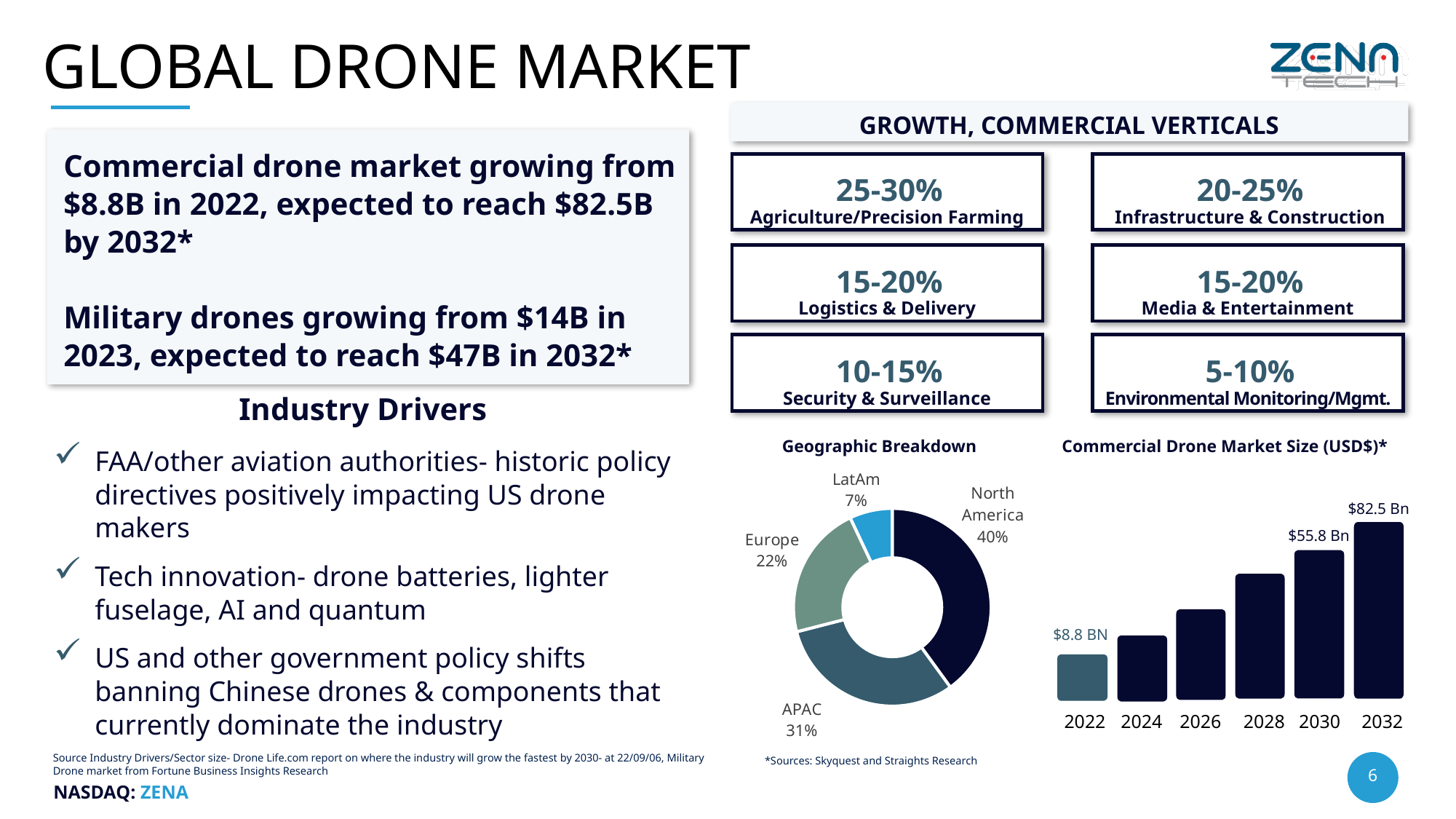
In the Commercial Drone Market Size (USD$) chart, do the values rise or fall from 2022 to 2032? Rise In the Commercial Drone Market Size (USD$) chart, what is the value for 2030? $55.8 Bn In the Geographic Breakdown chart, which region has the largest share? North America What kind of chart is the Geographic Breakdown chart? Donut (pie) chart In the Commercial Drone Market Size (USD$) chart, which year has the highest value? 2032 In the Geographic Breakdown chart, how many percentage points larger is Europe's share than LatAm's? 15 In the Geographic Breakdown chart, how many regions are shown? 4 In the Geographic Breakdown chart, which region has the smallest share? LatAm In the Commercial Drone Market Size (USD$) chart, what is the value for 2022? $8.8 BN In the Commercial Drone Market Size (USD$) chart, how many years are shown on the x axis? 6 In the Geographic Breakdown chart, what share does APAC hold? 31% In the Geographic Breakdown chart, what share does North America hold? 40%